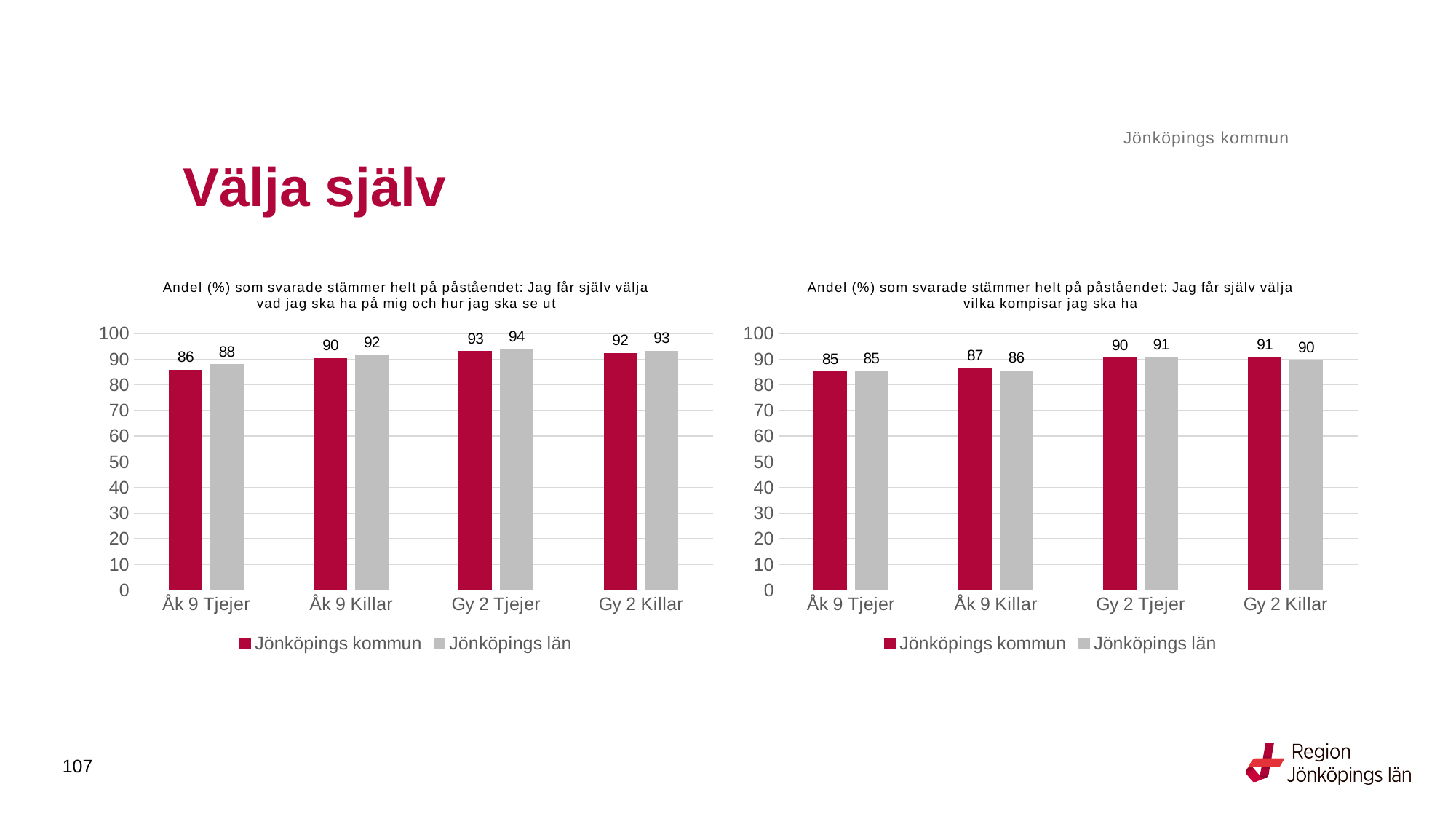
How many categories are shown on the x axis of the left chart? 4 In the left chart (about choosing what to wear and how to look), which category has the lowest value for Jönköpings kommun? Åk 9 Tjejer In the right chart (about choosing friends), which is larger for Gy 2 Killar: Jönköpings kommun or Jönköpings län? Jönköpings kommun In the left chart (about choosing what to wear and how to look), what is the value for Jönköpings kommun for Åk 9 Tjejer? 86 What kind of chart is the right chart (about choosing friends)? Bar chart In the left chart (about choosing what to wear and how to look), which category has the highest value for Jönköpings län? Gy 2 Tjejer In the left chart (about choosing what to wear and how to look), what is the difference between Jönköpings län and Jönköpings kommun for Åk 9 Killar? 2 In the right chart (about choosing friends), what is the difference between Jönköpings kommun for Gy 2 Tjejer and Jönköpings kommun for Åk 9 Tjejer? 5 In the left chart (about choosing what to wear and how to look), what is the value for Jönköpings län for Gy 2 Tjejer? 94 In the right chart (about choosing friends), what is the value for Jönköpings län for Gy 2 Killar? 90 How many series does the legend of the right chart list? 2 In the right chart (about choosing friends), what is the value for Jönköpings kommun for Åk 9 Killar? 87